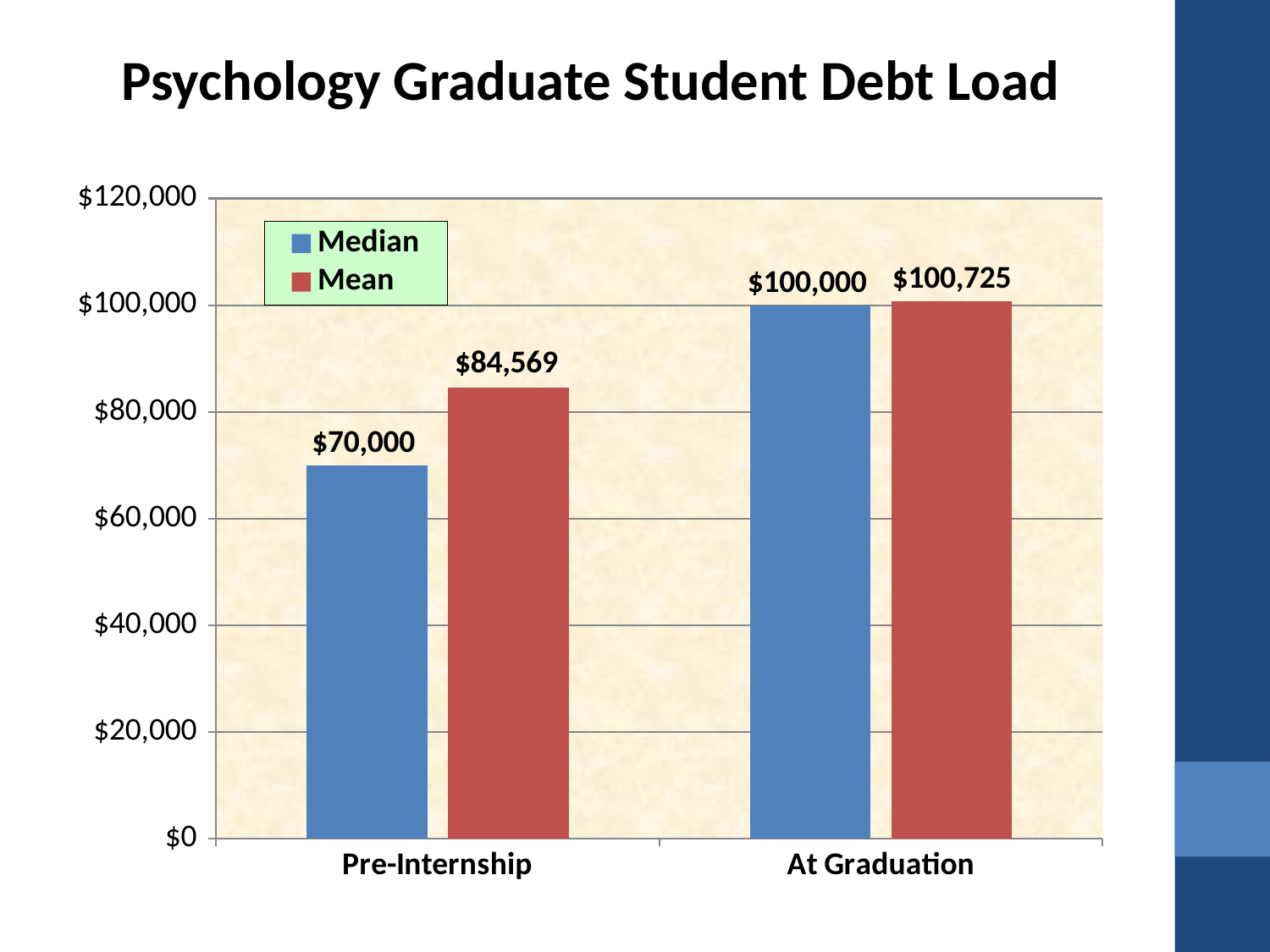
Which is larger for Pre-Internship, the Median or the Mean debt load? Mean Which category has the highest Mean debt load? At Graduation What is the Mean debt load for Pre-Internship? $84,569 Which category has the lowest Median debt load? Pre-Internship What is the Mean debt load At Graduation? $100,725 What type of chart is shown on the slide? Bar chart How many series does the legend list? 2 What is the difference between the Median debt load At Graduation and Pre-Internship? $30,000 How many categories are shown on the x axis? 2 What is the Median debt load for Pre-Internship? $70,000 What is the Median debt load At Graduation? $100,000 What is the difference between the Mean and Median debt load for Pre-Internship? $14,569